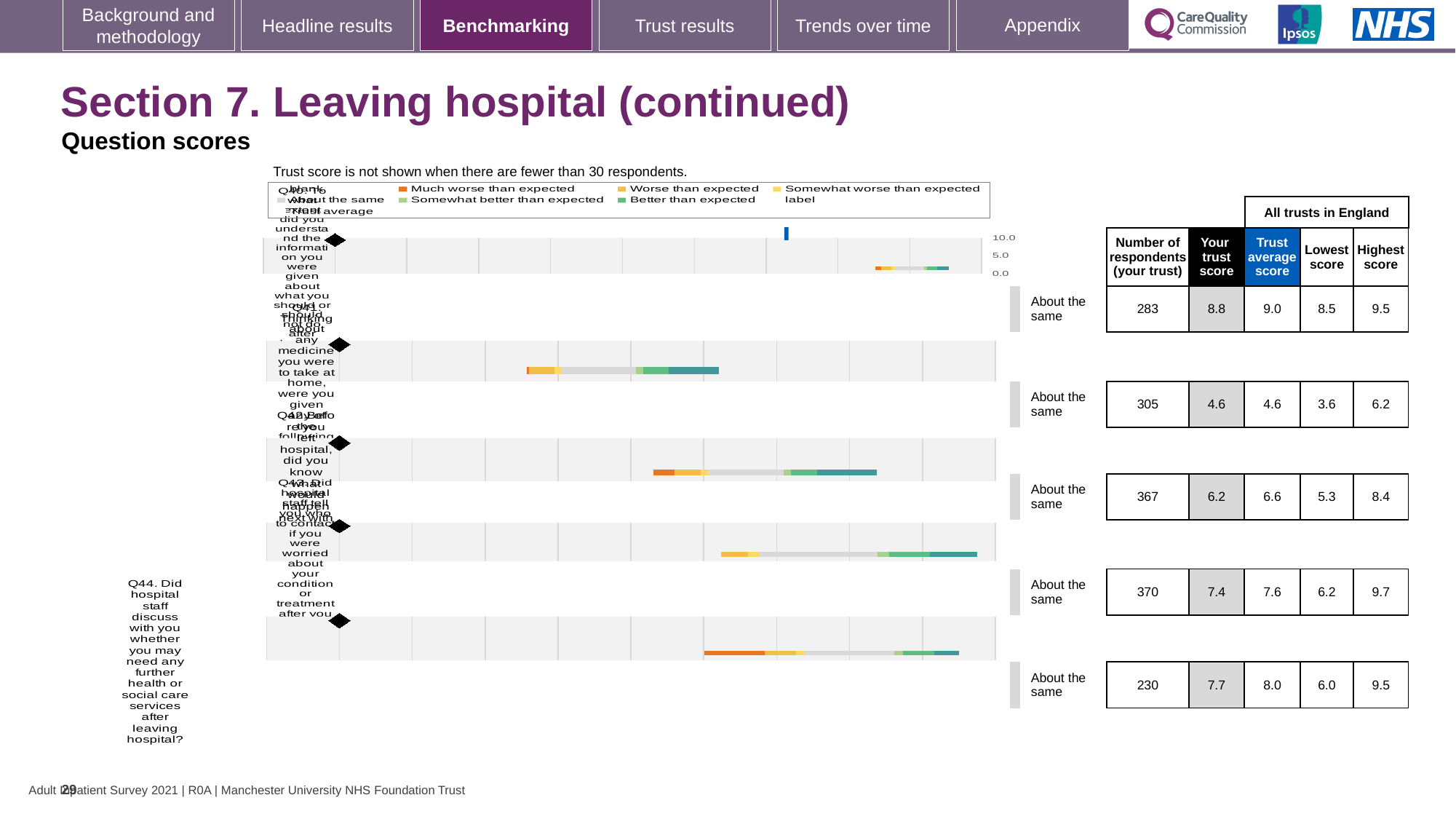
Which row has the highest 'Your trust score' value? the first row (8.8) What comparison label is shown next to each question row in the chart? About the same What is the trust's score for Q44 (the last row)? 7.7 What kind of chart is used to show the question scores on this slide? bar chart What is the highest score across all trusts in England for Q44 (the last row)? 9.5 What is the number of respondents for Q44 (the last row)? 230 Is the trust's score for the first row larger or smaller than the trust average score for that row? smaller What is the difference between the trust average score and the trust's own score for Q44 (the last row)? 0.3 How many question rows are plotted in the chart? 5 Which row has the lowest 'Your trust score' value? the second row (4.6) What is the trust average score for Q44 (the last row)? 8.0 Which row has the largest number of respondents? the fourth row (370)